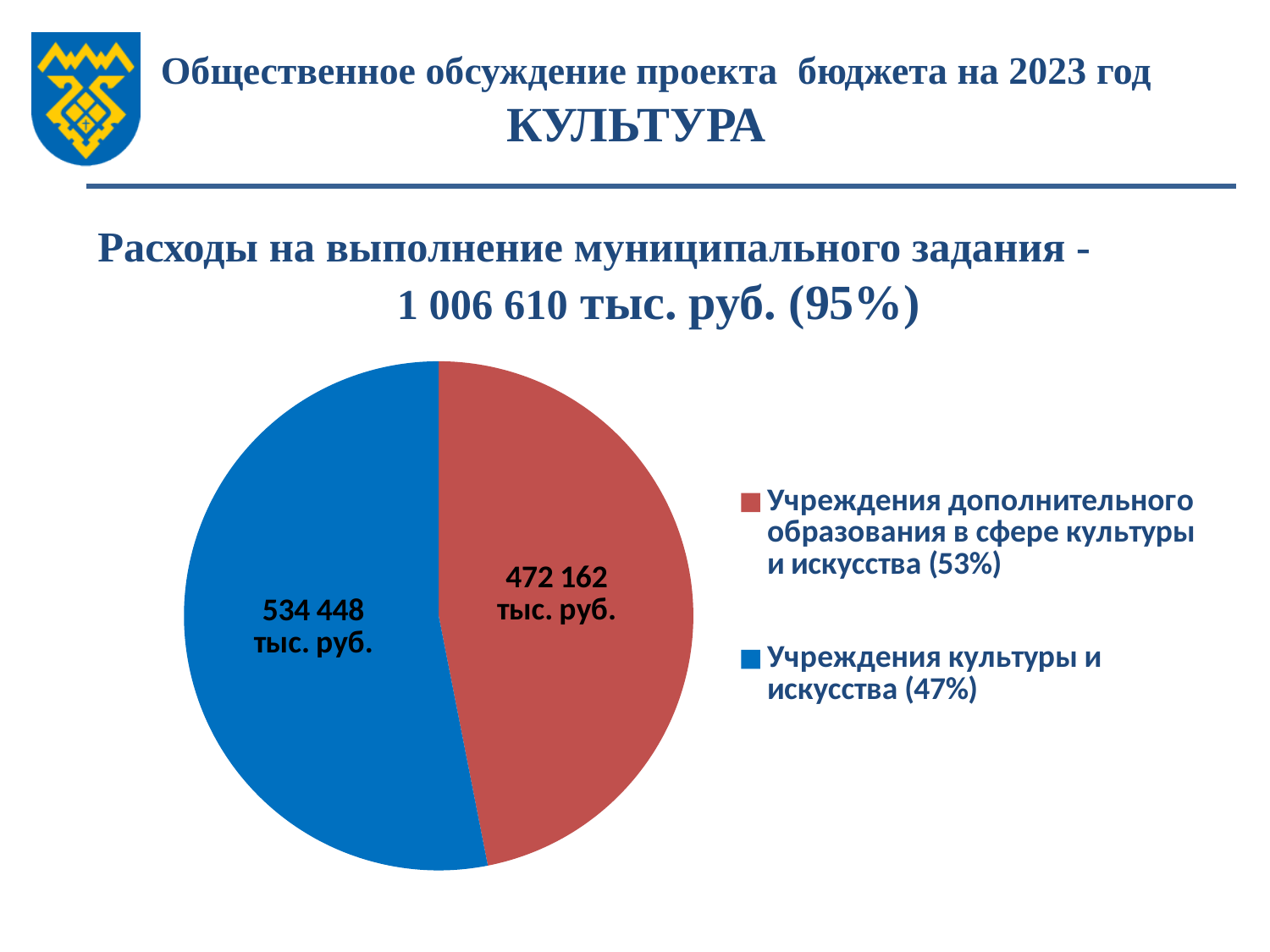
How many slices does the pie chart have? 2 What is the difference between the two values printed on the pie chart, 534 448 and 472 162 тыс. руб.? 62 286 тыс. руб. What value is printed on the red slice of the pie chart? 472 162 тыс. руб. Is the value printed on the blue slice (534 448 тыс. руб.) larger or smaller than the value printed on the red slice (472 162 тыс. руб.)? Larger What legend entry corresponds to the red slice of the pie chart? Учреждения дополнительного образования в сфере культуры и искусства (53%) What value is printed on the blue slice of the pie chart? 534 448 тыс. руб. What kind of chart is shown on the slide? Pie chart What legend entry corresponds to the blue slice of the pie chart? Учреждения культуры и искусства (47%) What is the total of the two values printed on the pie chart slices? 1 006 610 тыс. руб. Which slice of the pie chart has the larger printed value, the blue one or the red one? The blue one Which slice of the pie chart has the smaller printed value, the blue one or the red one? The red one